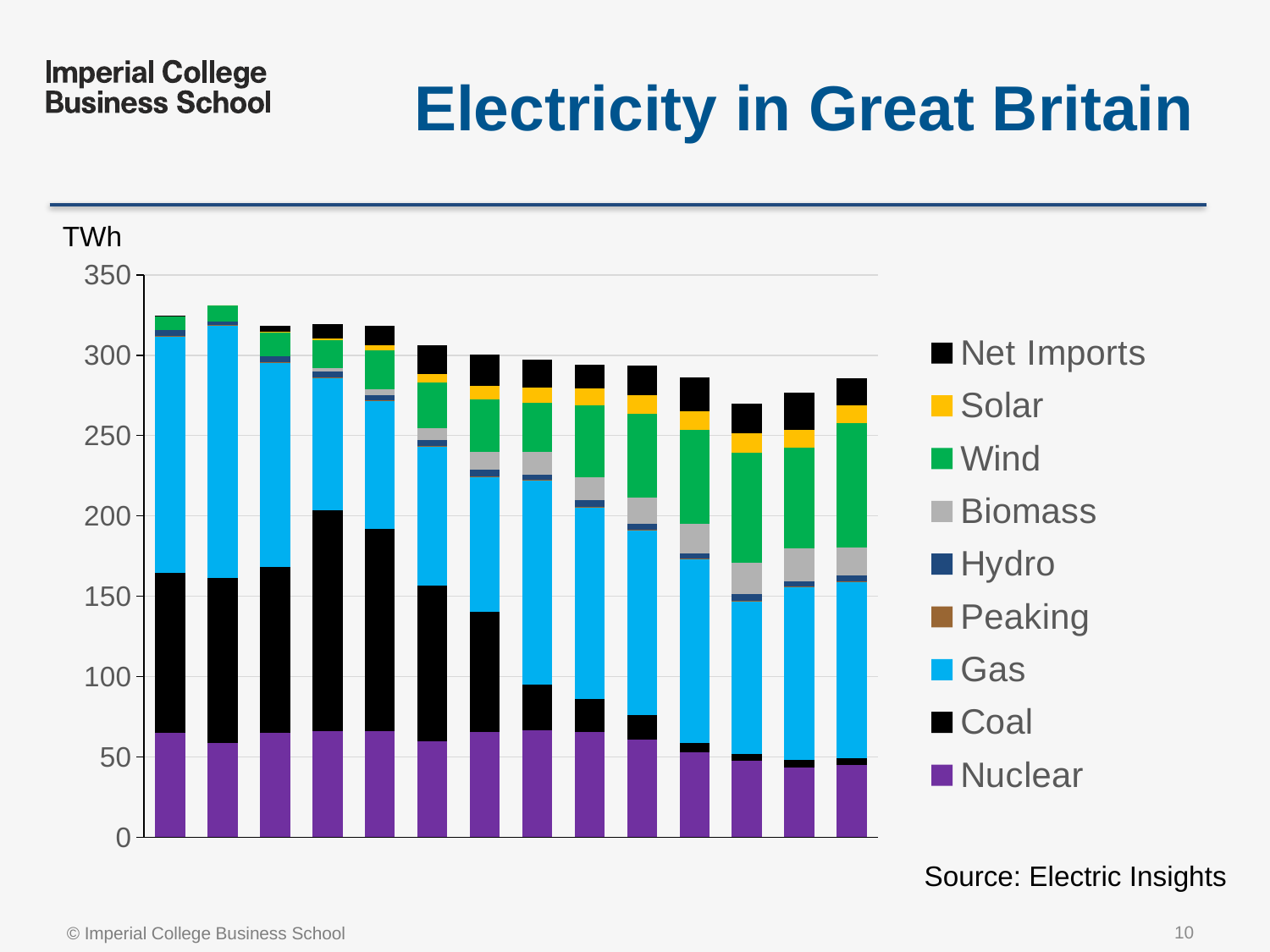
How many bars are plotted in the chart? 14 Is the Coal value in the first (leftmost) bar greater or less than 50? greater Is the total of the last (rightmost) bar greater or less than 300? less Is the total of the first (leftmost) bar greater or less than 300? greater How many series does the legend list? 9 Is the Coal value larger in the first (leftmost) bar or in the last (rightmost) bar? first bar What kind of chart is shown on the slide? Stacked bar chart Which series is plotted at the bottom of each stacked bar? Nuclear What unit is shown on the y axis of the chart? TWh Do the bar totals generally rise or fall from left to right along the x axis? fall